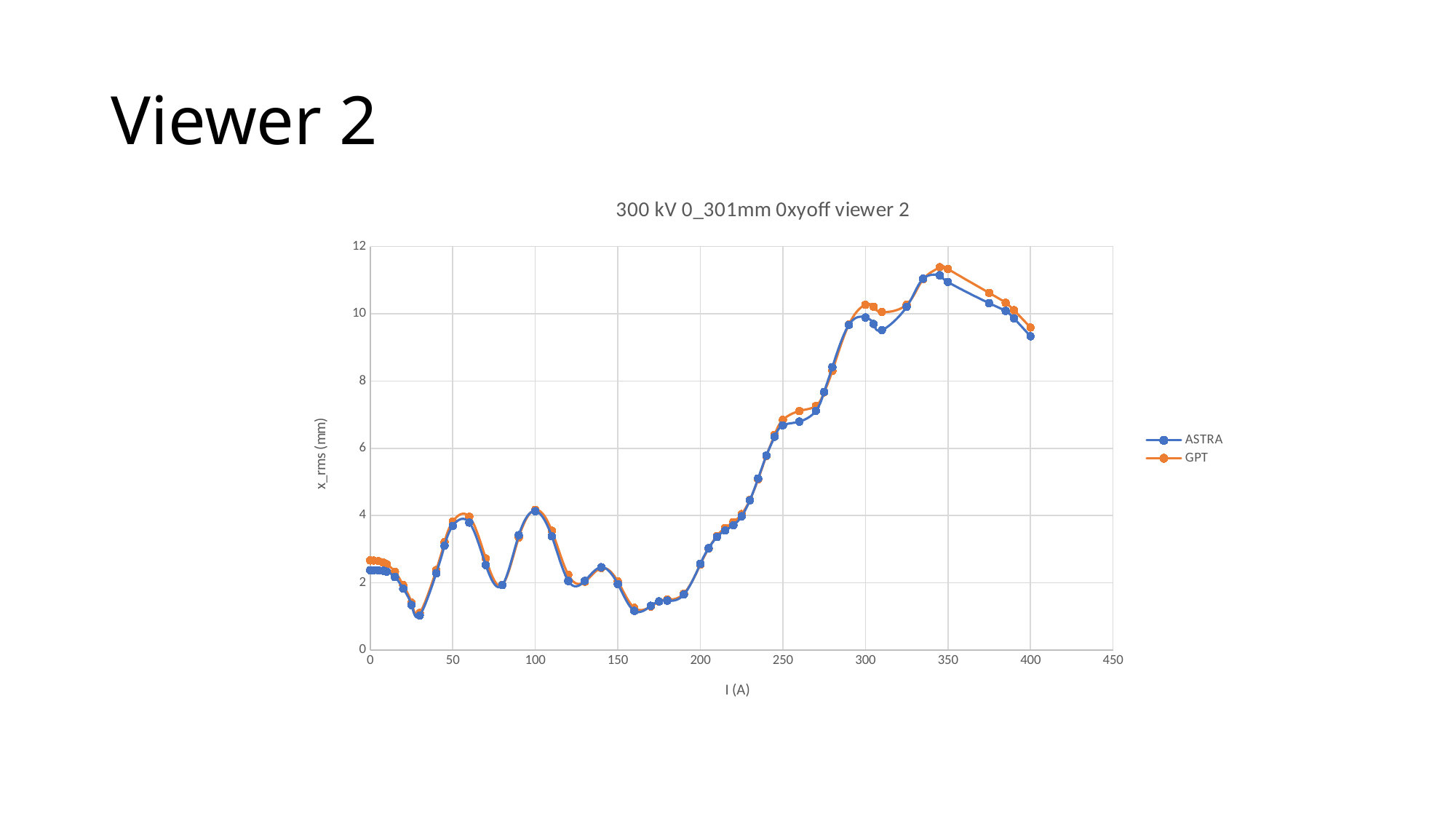
Is the value for GPT at 350 A greater or less than 10? greater At 310 A, which series has the larger value, ASTRA or GPT? GPT Is the value for ASTRA at 30 A greater or less than 2? less How many series does the legend list? 2 What is the label of the y axis? x_rms (mm) Is the value for ASTRA at 400 A greater or less than 10? less What kind of chart is shown on the slide? line chart Do the values rise or fall along the x axis between 350 A and 400 A? fall Do the values rise or fall along the x axis between 200 A and 300 A? rise What is the title of the chart? 300 kV 0_301mm 0xyoff viewer 2